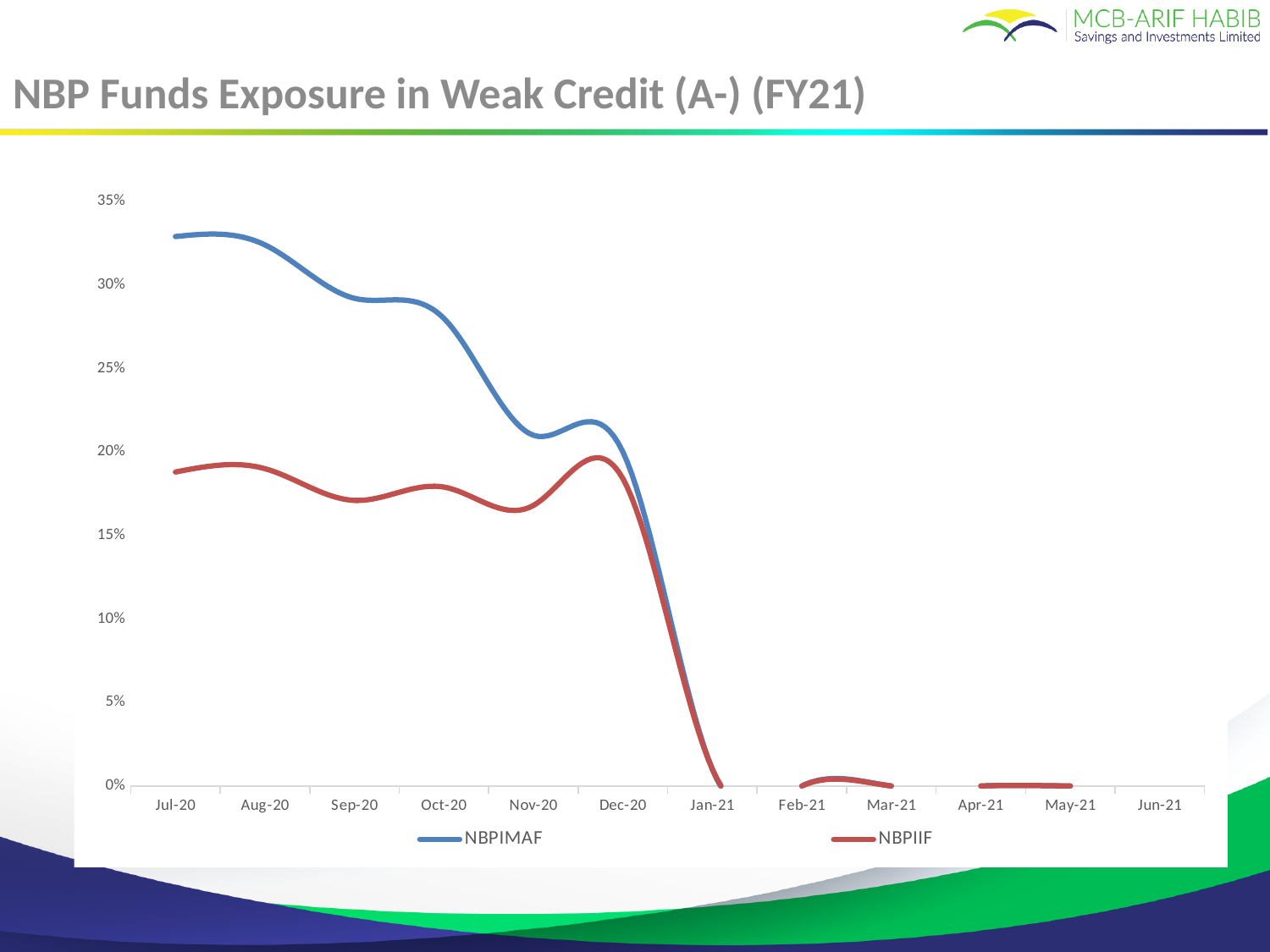
At Jul-20, which series has the higher value, NBPIMAF or NBPIIF? NBPIMAF Is the value for NBPIIF at Jul-20 greater or less than 20%? less What kind of chart is shown on the slide? line chart How many months are labelled along the x axis? 12 Is the value for NBPIMAF at Oct-20 greater or less than 25%? greater Is the value for NBPIMAF at Nov-20 greater or less than 20%? greater Which is larger for NBPIMAF, the value at Sep-20 or the value at Dec-20? Sep-20 Does the NBPIMAF line rise or fall from Jul-20 to Jan-21? fall How many series does the legend list? 2 What colour is the NBPIIF line? red